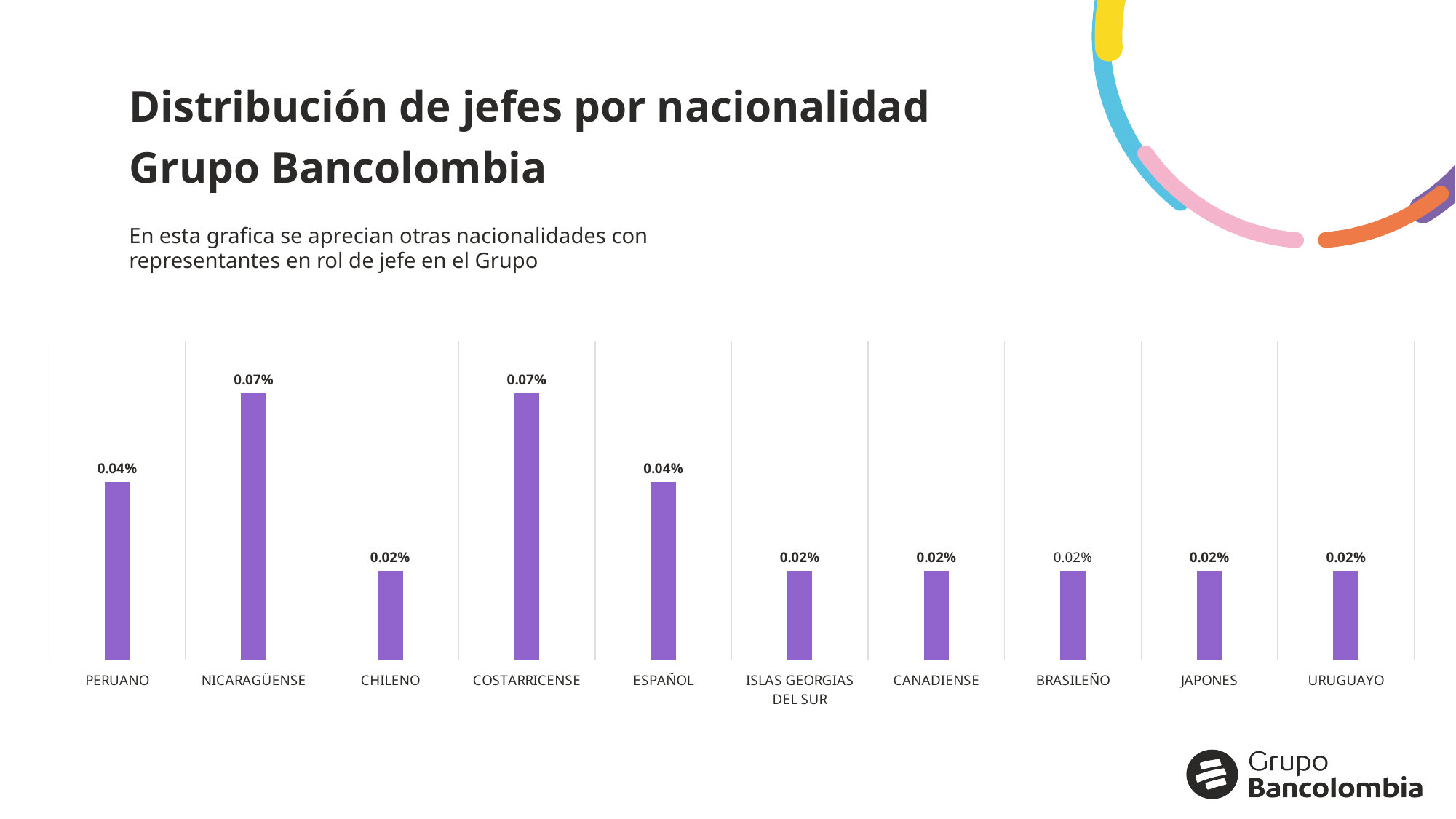
What kind of chart is shown on the slide? Bar chart What is the difference between the values for NICARAGÜENSE and PERUANO? 0.03% What is the value for COSTARRICENSE? 0.07% What colour are the bars in the chart? Purple What is the value for ISLAS GEORGIAS DEL SUR? 0.02% What is the difference between the values for ESPAÑOL and CANADIENSE? 0.02% What is the value for CHILENO? 0.02% What is the value for NICARAGÜENSE? 0.07% Which is larger, the value for COSTARRICENSE or the value for ESPAÑOL? COSTARRICENSE What is the value for ESPAÑOL? 0.04% How many nationalities are shown on the chart? 10 What is the value for PERUANO? 0.04%